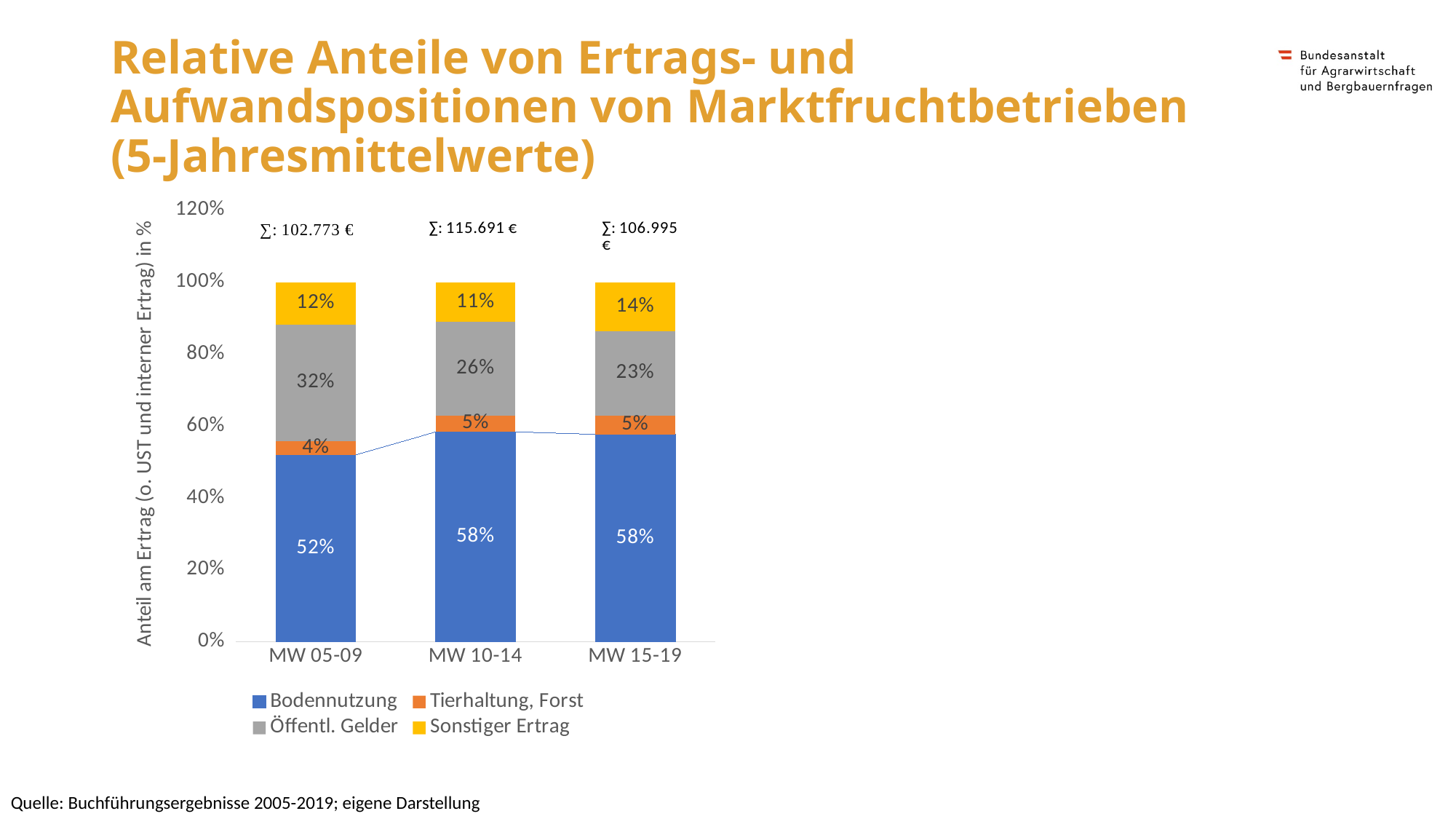
Which period has the lowest value for Sonstiger Ertrag? MW 10-14 What is the value for Öffentl. Gelder in MW 10-14? 26% What is the value for Sonstiger Ertrag in MW 15-19? 14% What is the value for Tierhaltung, Forst in MW 05-09? 4% What is the difference between the Öffentl. Gelder values for MW 05-09 and MW 15-19? 9% Which is larger: Bodennutzung in MW 05-09 or Bodennutzung in MW 10-14? MW 10-14 What is the value for Bodennutzung in MW 05-09? 52% Which period has the highest value for Öffentl. Gelder? MW 05-09 What is the total sum (∑) shown above the MW 10-14 bar? 115.691 € What kind of chart is shown on the slide? Stacked bar chart How many series does the legend list? 4 How many periods are shown on the x axis? 3